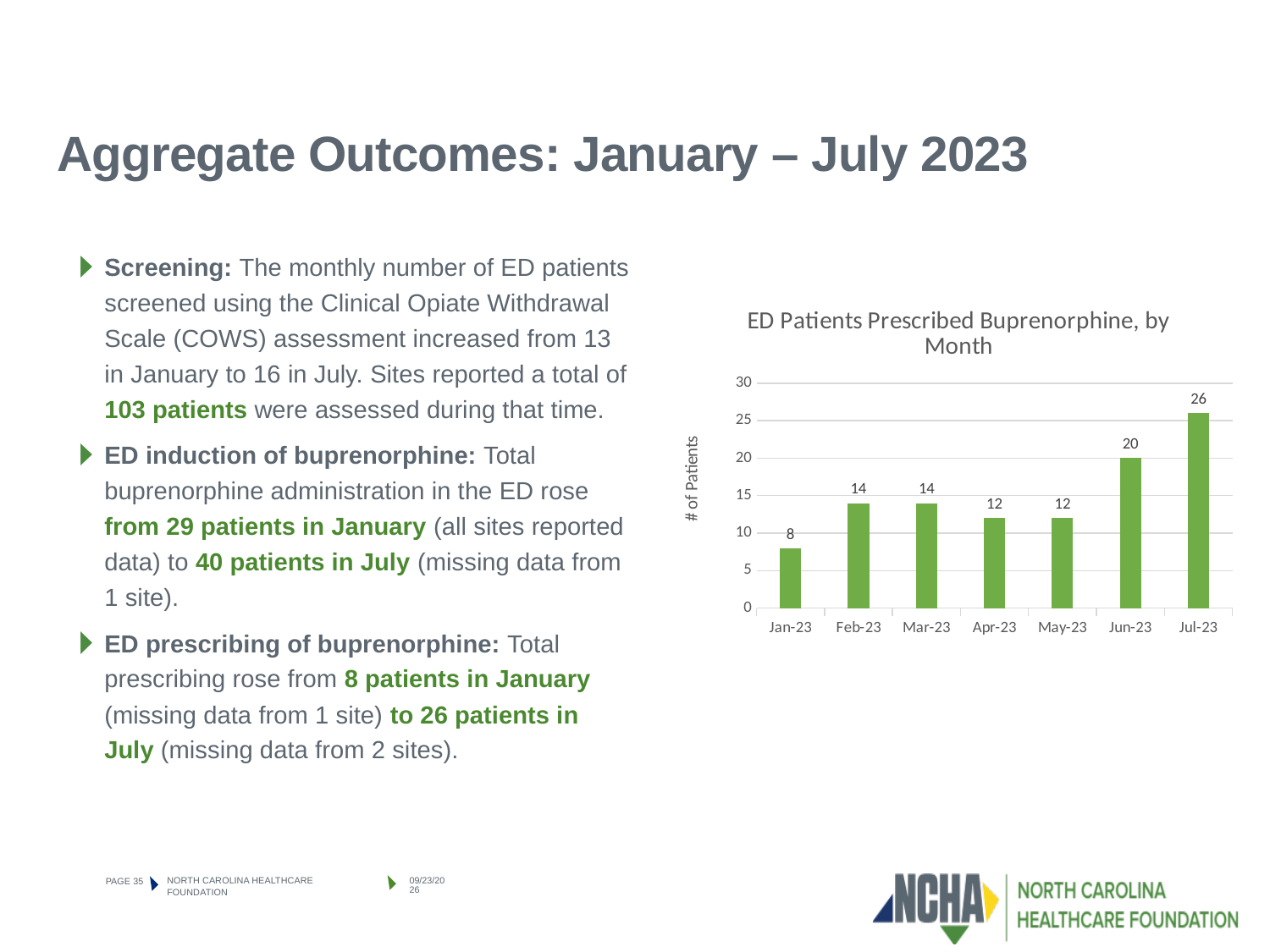
How many months are shown on the x axis of the chart? 7 Which is larger, the value for Feb-23 or the value for Apr-23? Feb-23 What is the value for Jan-23 in the chart? 8 What is the value for Apr-23 in the chart? 12 What is the difference between the values for Jul-23 and Jan-23? 18 Is the value for Jul-23 greater or less than 25? greater What is the title of the chart? ED Patients Prescribed Buprenorphine, by Month What kind of chart is shown on the slide? Bar chart Which month has the lowest number of ED patients prescribed buprenorphine? Jan-23 Which month has the highest number of ED patients prescribed buprenorphine? Jul-23 What is the difference between the values for Jun-23 and May-23? 8 What is the value for Jun-23 in the chart? 20